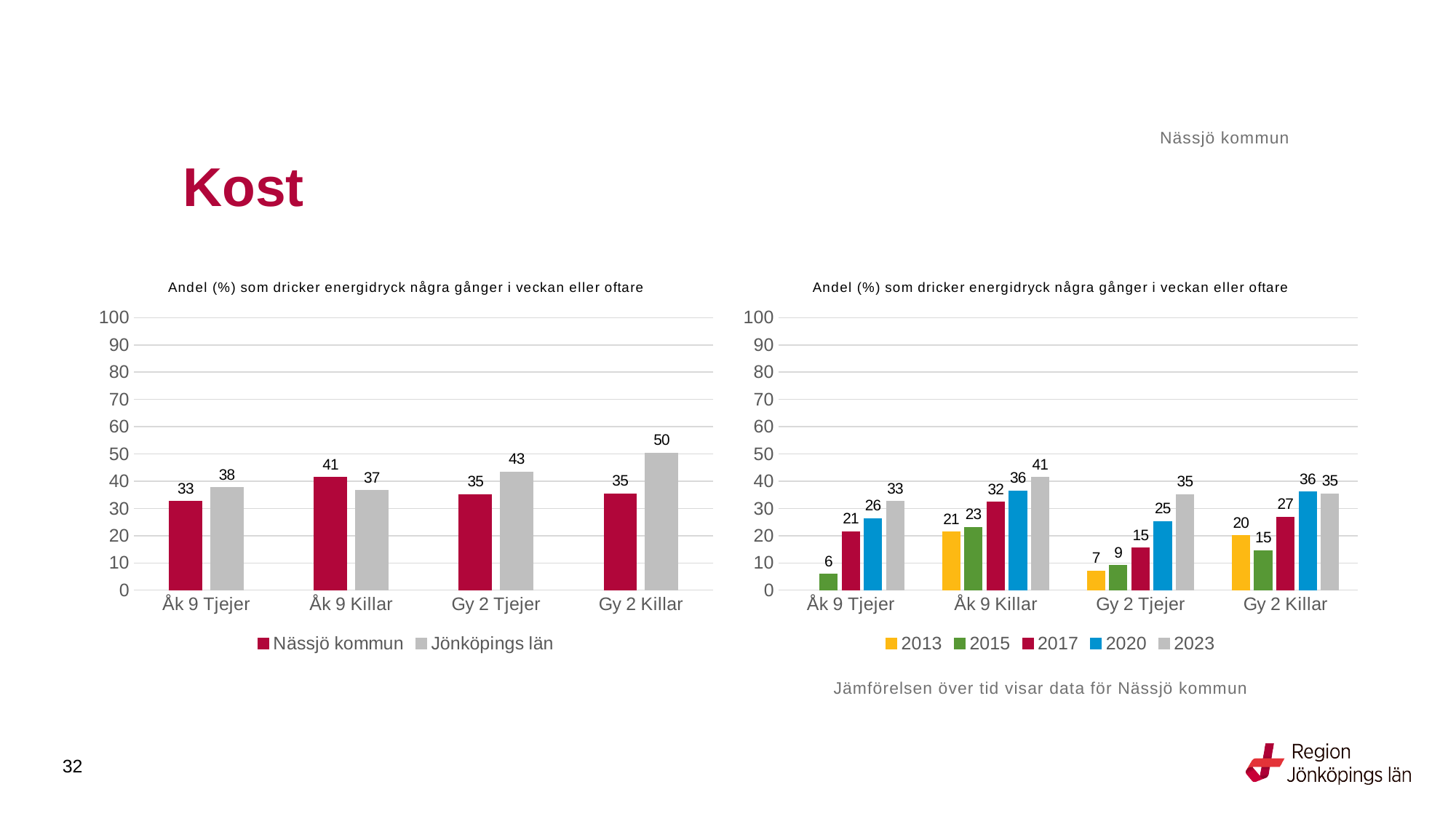
In the right chart, do the values for Gy 2 Tjejer rise or fall from 2013 to 2023? rise In the right chart, what is the value for 2023 for Åk 9 Killar? 41 How many series does the legend of the left chart list? 2 In the left chart, which is larger for Åk 9 Killar: Nässjö kommun or Jönköpings län? Nässjö kommun What kind of chart is the right chart? bar chart In the left chart, which category has the highest value for Jönköpings län? Gy 2 Killar In the left chart, what is the difference between Jönköpings län and Nässjö kommun for Gy 2 Killar? 15 How many series does the legend of the right chart list? 5 In the right chart, which year has the lowest value for Gy 2 Killar? 2015 In the left chart, what is the value for Jönköpings län for Gy 2 Killar? 50 In the left chart, what is the value for Nässjö kommun for Åk 9 Killar? 41 In the right chart, what is the value for 2015 for Åk 9 Tjejer? 6